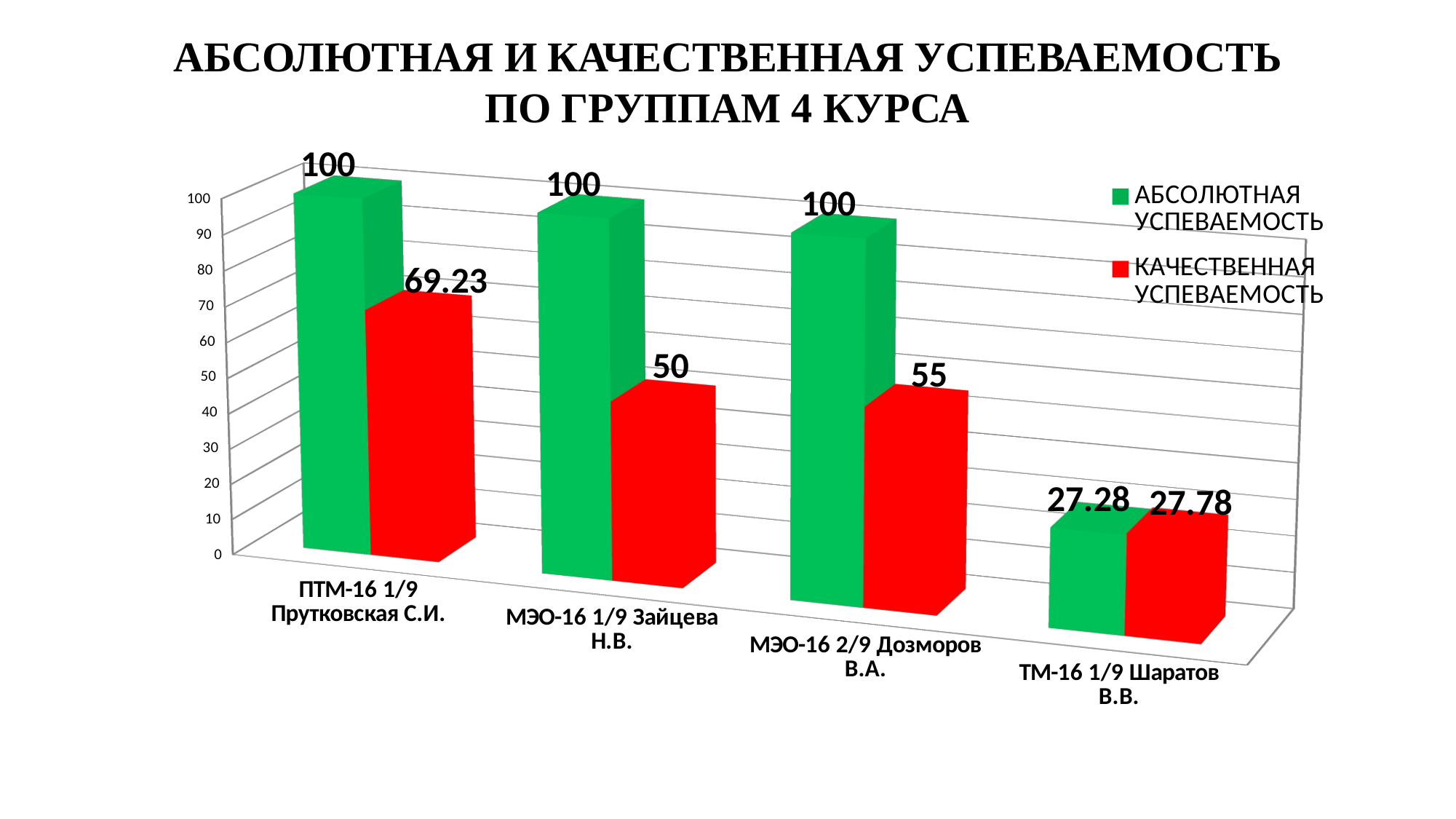
What is the КАЧЕСТВЕННАЯ УСПЕВАЕМОСТЬ value for МЭО-16 2/9 Дозморов В.А.? 55 Which group has the lowest АБСОЛЮТНАЯ УСПЕВАЕМОСТЬ? ТМ-16 1/9 Шаратов В.В. What kind of chart is shown on the slide? Bar chart Which is larger: the КАЧЕСТВЕННАЯ УСПЕВАЕМОСТЬ for МЭО-16 2/9 Дозморов В.А. or for МЭО-16 1/9 Зайцева Н.В.? МЭО-16 2/9 Дозморов В.А. What is the АБСОЛЮТНАЯ УСПЕВАЕМОСТЬ value for ТМ-16 1/9 Шаратов В.В.? 27.28 Which group has the highest КАЧЕСТВЕННАЯ УСПЕВАЕМОСТЬ? ПТМ-16 1/9 Прутковская С.И. What is the difference between the КАЧЕСТВЕННАЯ УСПЕВАЕМОСТЬ values for ПТМ-16 1/9 Прутковская С.И. and МЭО-16 1/9 Зайцева Н.В.? 19.23 What colour represents АБСОЛЮТНАЯ УСПЕВАЕМОСТЬ in the chart? Green How many series does the legend list? 2 What is the КАЧЕСТВЕННАЯ УСПЕВАЕМОСТЬ value for МЭО-16 1/9 Зайцева Н.В.? 50 What is the КАЧЕСТВЕННАЯ УСПЕВАЕМОСТЬ value for ПТМ-16 1/9 Прутковская С.И.? 69.23 How many groups are shown on the x axis? 4